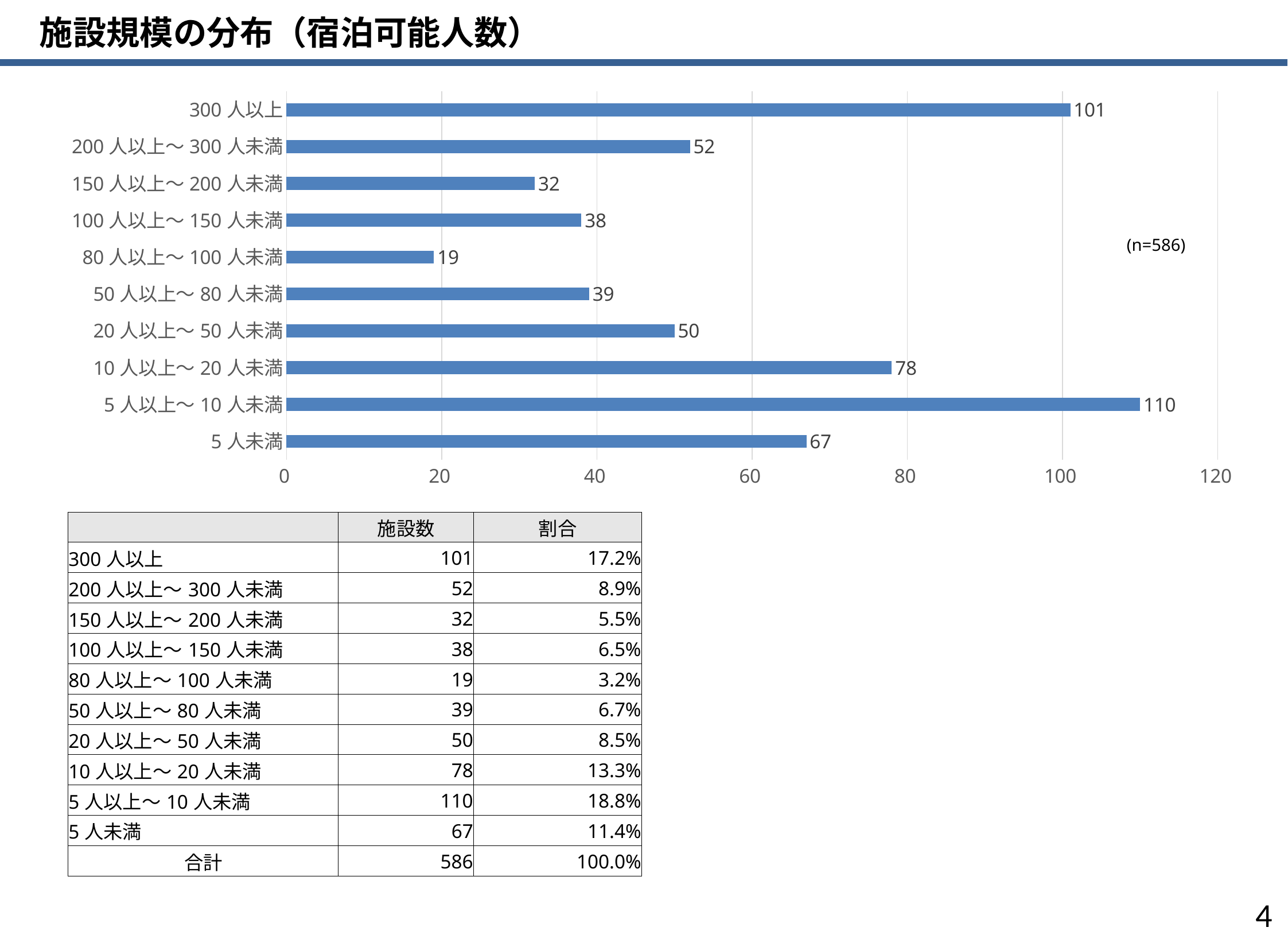
What is the value for 80人以上～100人未満? 19 How many categories are shown in the chart? 10 What is the value for 5人未満? 67 Which is larger, the value for 200人以上～300人未満 or the value for 20人以上～50人未満? 200人以上～300人未満 What is the sample size (n) noted on the chart? 586 What is the difference between the values for 5人以上～10人未満 and 300人以上? 9 Which category has the lowest value? 80人以上～100人未満 Is the value for 150人以上～200人未満 greater or less than 40? less Which category has the highest value? 5人以上～10人未満 What is the difference between the values for 10人以上～20人未満 and 20人以上～50人未満? 28 What kind of chart is shown on the slide? bar chart What is the value for 300人以上? 101